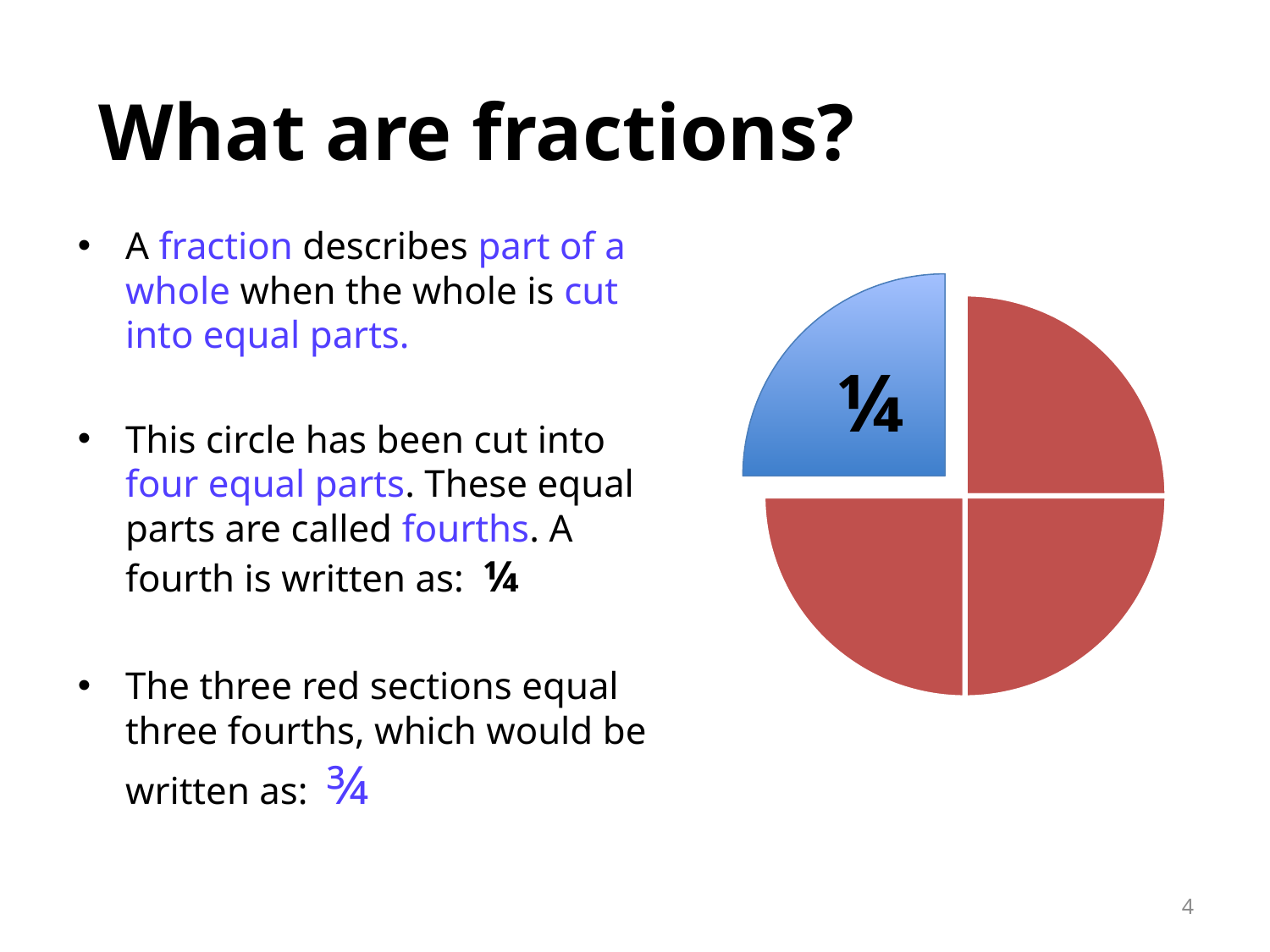
How many equal parts is the circle in the pie chart cut into? 4 What fraction is printed on the blue slice of the pie chart? ¼ What fraction of the whole do the three red sections of the pie chart represent, as written on the slide? ¾ What colour are the three sections of the pie chart that are not labelled? red Are the red sections of the pie chart together larger or smaller than the blue section? larger How many red sections does the pie chart have? 3 How many blue sections does the pie chart have? 1 Which colour slice of the pie chart is pulled out from the rest of the circle? blue What kind of chart is shown on the slide? pie chart